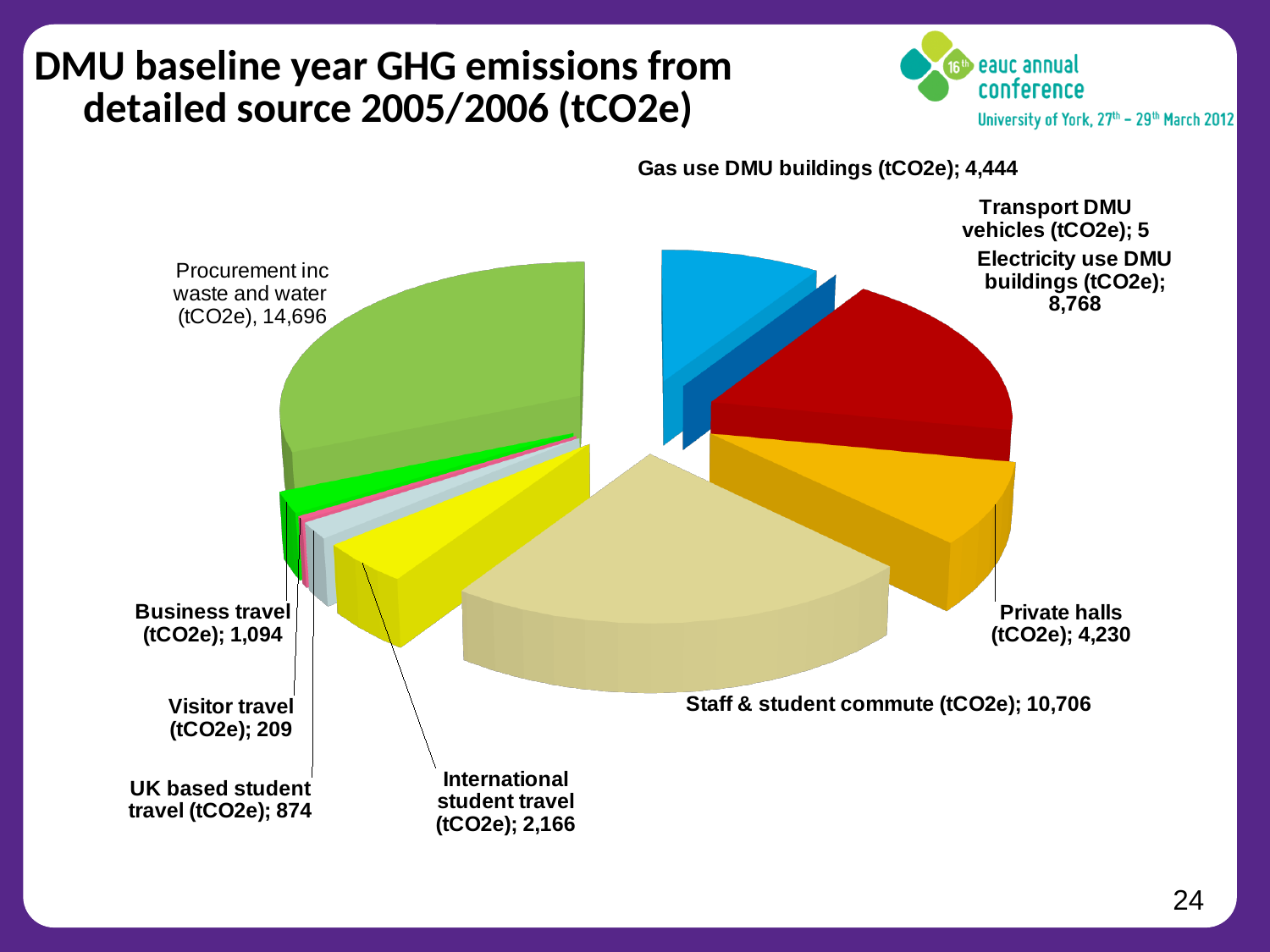
What type of chart is shown on the slide? Pie chart Which is larger, Business travel or UK based student travel? Business travel What is the value for International student travel (tCO2e)? 2,166 What is the difference between Gas use DMU buildings and Private halls? 214 What is the value for Electricity use DMU buildings (tCO2e)? 8,768 What is the difference between Procurement inc waste and water and Staff & student commute? 3,990 What is the title of the chart on the slide? DMU baseline year GHG emissions from detailed source 2005/2006 (tCO2e) What is the value for Staff & student commute (tCO2e)? 10,706 Which source has the smallest emissions in the pie chart? Transport DMU vehicles (tCO2e) Which source has the largest emissions in the pie chart? Procurement inc waste and water (tCO2e) How many emission sources are shown in the pie chart? 10 What is the value for Private halls (tCO2e)? 4,230